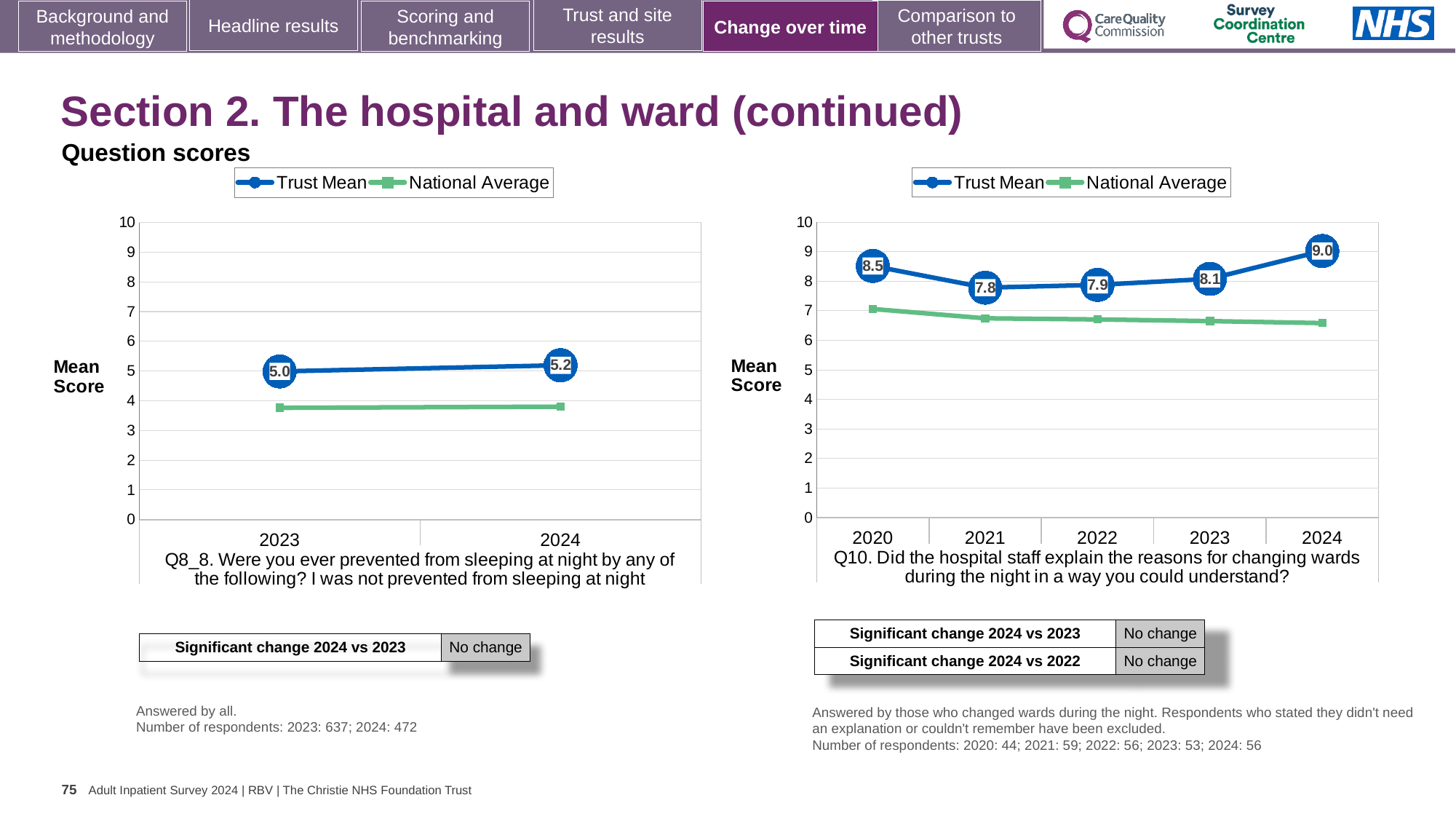
In the right chart (Q10), what is the Trust Mean score for 2021? 7.8 How many series does the legend of the left chart (Q8_8) list? 2 How many years are shown on the x axis of the right chart (Q10)? 5 In the right chart (Q10), what is the difference between the Trust Mean scores for 2024 and 2020? 0.5 In the left chart (Q8_8), what is the Trust Mean score for 2023? 5.0 In the right chart (Q10), which year has the lowest Trust Mean score? 2021 In the left chart (Q8_8), is the National Average value for 2024 greater or less than 4? less What kind of chart is the right chart (Q10)? Line chart In the right chart (Q10), which year has the highest Trust Mean score? 2024 In the left chart (Q8_8), what is the Trust Mean score for 2024? 5.2 In the right chart (Q10), is the Trust Mean score for 2022 or 2023 higher? 2023 In the right chart (Q10), is the National Average value for 2020 greater or less than 6? greater